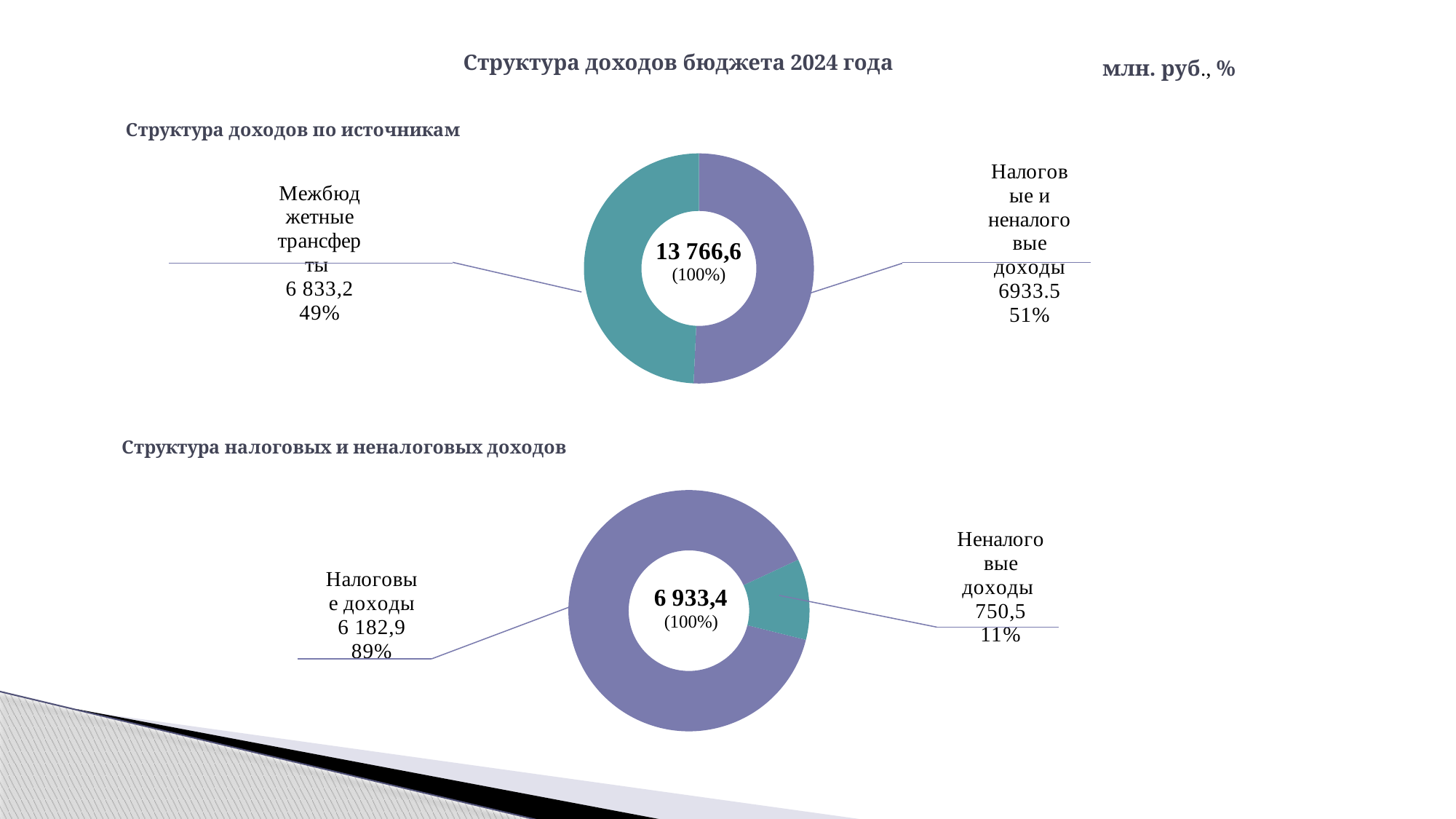
In the chart 'Структура доходов по источникам', how many categories are shown? 2 What kind of chart is used for 'Структура доходов по источникам'? Donut (pie) chart What is the main title of the slide above the two charts? Структура доходов бюджета 2024 года In the chart 'Структура налоговых и неналоговых доходов', what share do Налоговые доходы make up? 89% In the chart 'Структура налоговых и неналоговых доходов', which category has the smallest share? Неналоговые доходы In the chart 'Структура доходов по источникам', what total is shown in the centre of the donut? 13 766,6 In the chart 'Структура доходов по источникам', what is the value for Межбюджетные трансферты? 6 833,2 In the chart 'Структура доходов по источникам', which category has the larger share? Налоговые и неналоговые доходы In the chart 'Структура налоговых и неналоговых доходов', what is the value for Неналоговые доходы? 750,5 In the chart 'Структура доходов по источникам', what share of the total do Налоговые и неналоговые доходы make up? 51% In the chart 'Структура налоговых и неналоговых доходов', what is the difference in percentage points between Налоговые доходы and Неналоговые доходы? 78 In the chart 'Структура налоговых и неналоговых доходов', what total is shown in the centre of the donut? 6 933,4